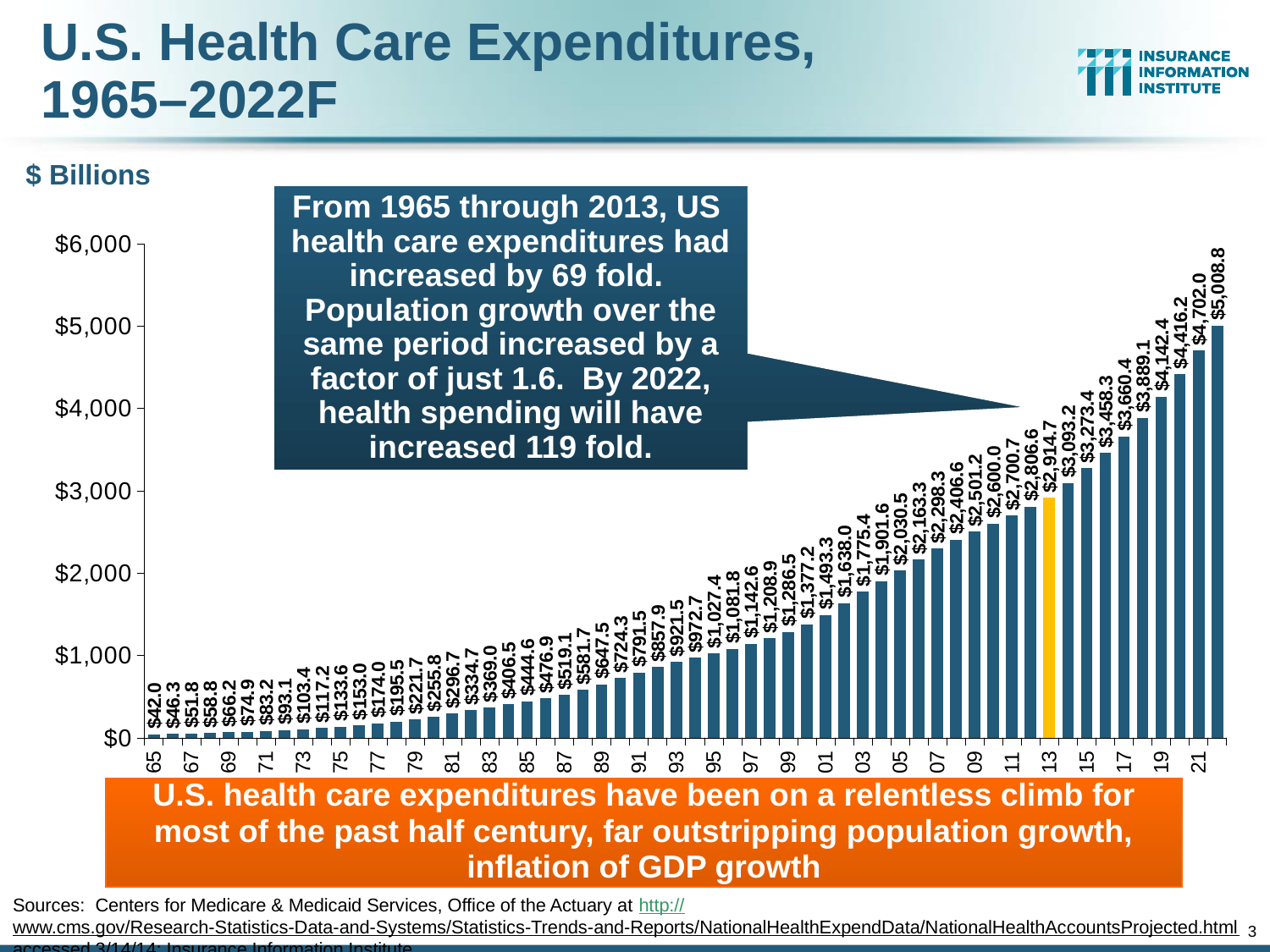
Is the value for 2017 greater or less than $3,000? greater Which is larger, the value for 2005 or the value for 1995? 2005 What is the difference between the 2022 value and the 2013 value? $2,094.1 Which year has the highest value? 2022 What is the value for 2022 (the last bar)? $5,008.8 Which year has the lowest value? 1965 Do the values rise or fall from 1965 to 2022? Rise How many bars (years) are plotted in the chart? 58 What is the value for 2000 (labelled 01 is the next bar)? $1,377.2 What is the value of the highlighted (yellow) bar for 2013? $2,914.7 What is the value for 1965 (the first bar)? $42.0 What kind of chart is shown? Bar chart